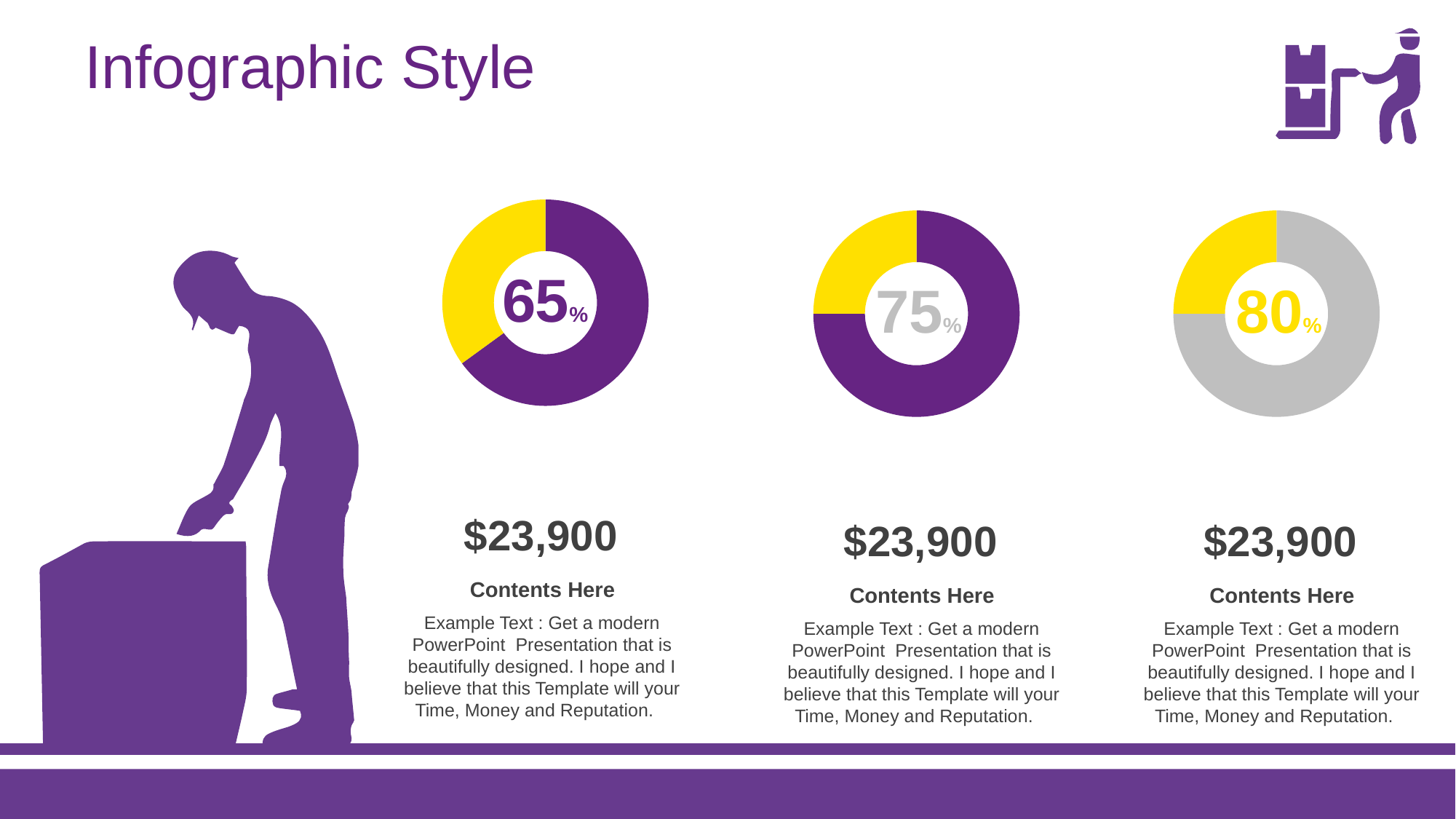
What is the difference between the percentage in the middle donut chart and the percentage in the left donut chart? 10% What two colours are used in the right donut chart? Yellow and grey Which of the three donut charts shows the highest percentage? The right chart (80%) What percentage is shown in the centre of the right donut chart? 80% How many donut charts are on the slide? 3 What percentage is shown in the centre of the left donut chart? 65% Which of the three donut charts shows the lowest percentage? The left chart (65%) What is the difference between the percentage in the right donut chart and the percentage in the left donut chart? 15% How many slices does the left donut chart have? 2 Is the percentage in the middle donut chart larger or smaller than the percentage in the right donut chart? Smaller What kind of chart is used three times on this slide? Donut (pie) chart What percentage is shown in the centre of the middle donut chart? 75%